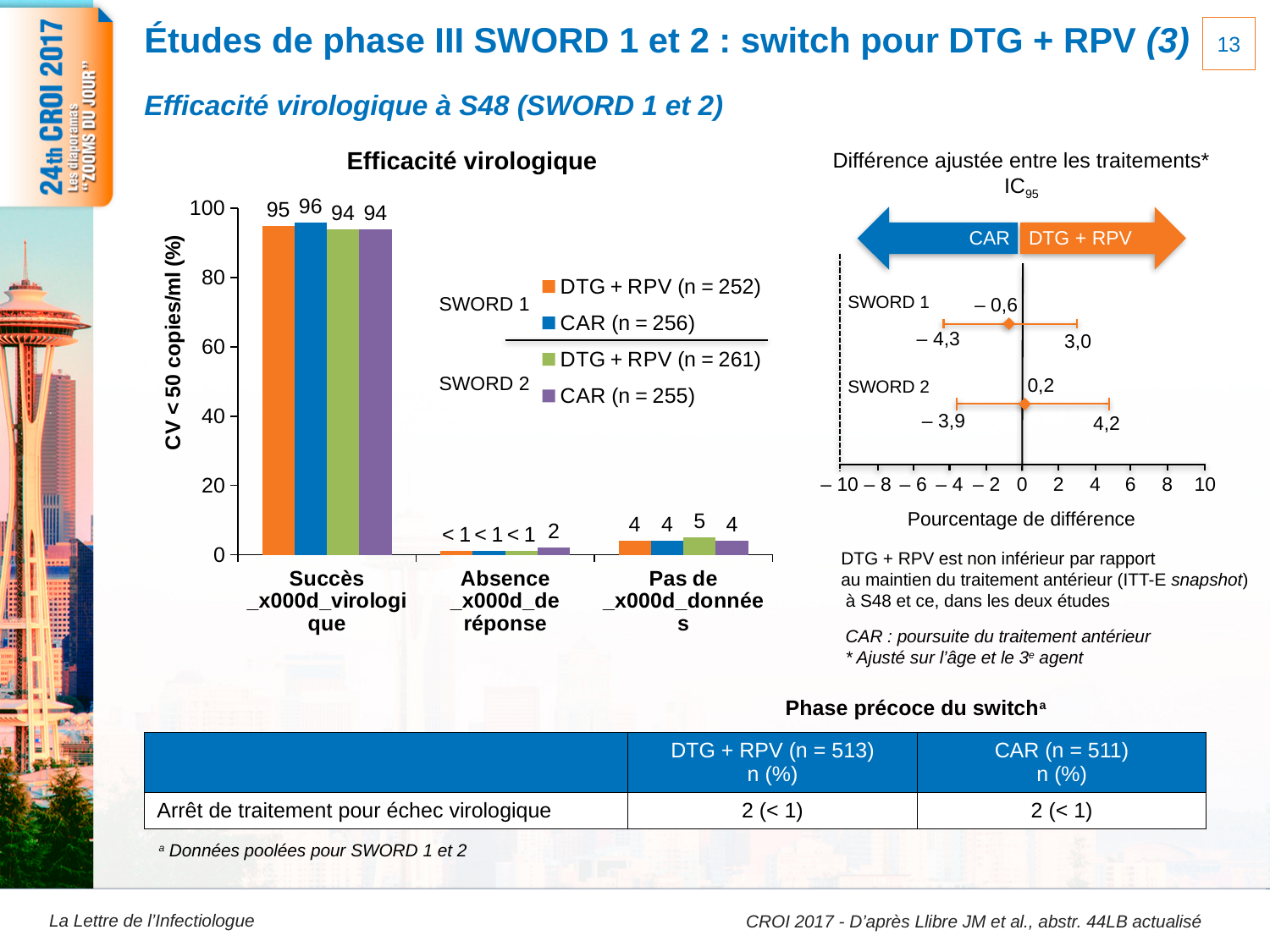
In the 'Efficacité virologique' bar chart, what is the value for SWORD 2 DTG + RPV (n = 261) in the 'Pas de données' category? 5 In the 'Différence ajustée entre les traitements' plot on the right, what is the point estimate for SWORD 2? 0,2 In the 'Efficacité virologique' bar chart, which series has the highest value in the 'Succès virologique' category? SWORD 1 CAR (n = 256) In the 'Efficacité virologique' bar chart, what is the difference between the SWORD 1 CAR (n = 256) and SWORD 2 CAR (n = 255) values in the 'Succès virologique' category? 2 In the 'Efficacité virologique' bar chart, which is larger in the 'Pas de données' category: SWORD 2 DTG + RPV (n = 261) or SWORD 2 CAR (n = 255)? SWORD 2 DTG + RPV (n = 261) What kind of chart is the 'Efficacité virologique' chart? bar chart How many series does the legend of the 'Efficacité virologique' bar chart list? 4 In the 'Efficacité virologique' bar chart, what is the value for SWORD 2 CAR (n = 255) in the 'Absence de réponse' category? 2 What is the y-axis label of the 'Efficacité virologique' bar chart? CV < 50 copies/ml (%) In the 'Efficacité virologique' bar chart, what is the value for SWORD 1 CAR (n = 256) in the 'Succès virologique' category? 96 In the 'Efficacité virologique' bar chart, what is the value for SWORD 1 DTG + RPV (n = 252) in the 'Succès virologique' category? 95 How many categories are shown on the x axis of the 'Efficacité virologique' chart? 3